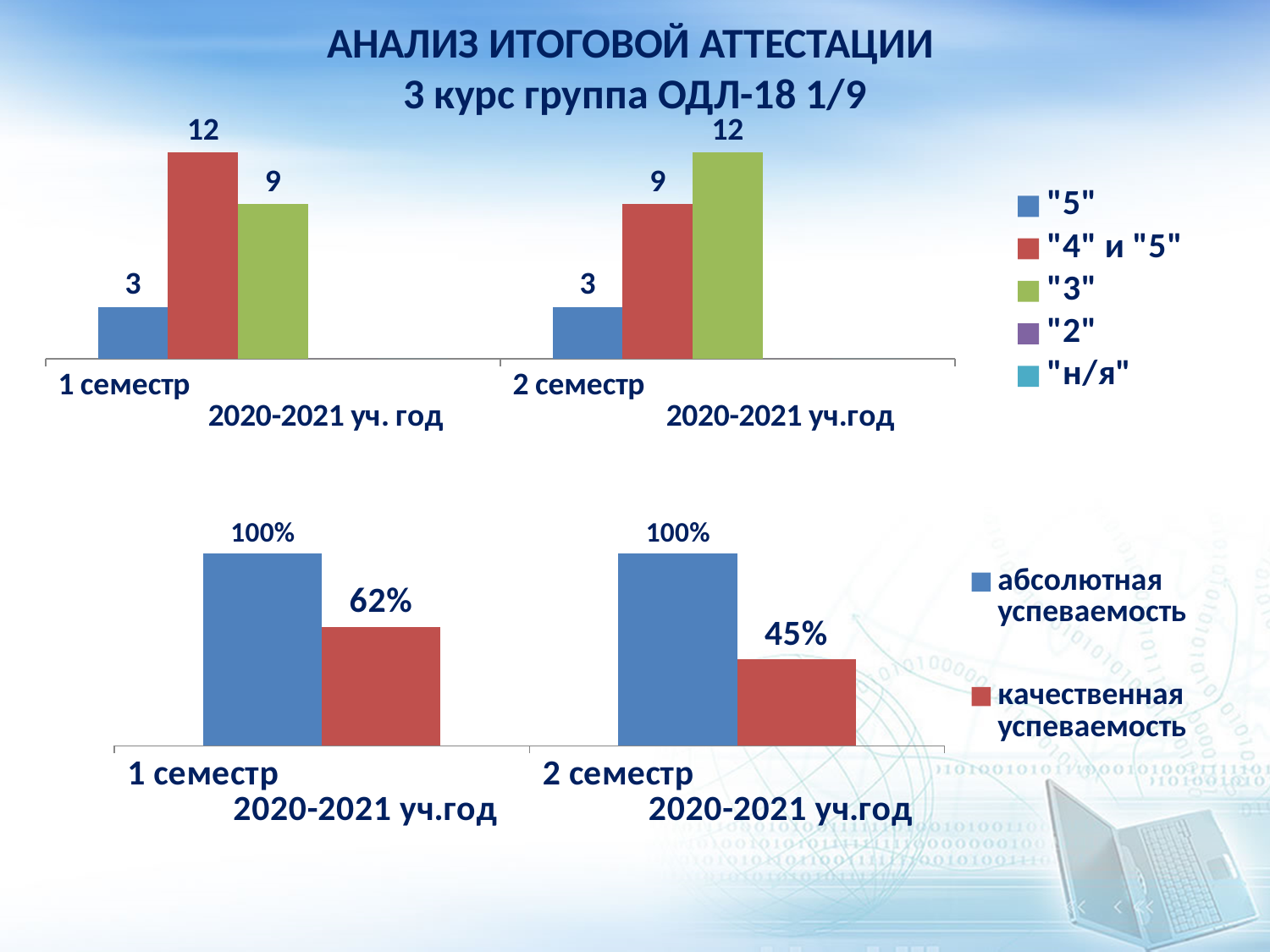
In the bottom chart, what is the value for качественная успеваемость in 2 семестр 2020-2021 уч.год? 45% In the top chart, what is the value for "3" in 2 семестр 2020-2021 уч.год? 12 In the top chart, which series has the highest value in 1 семестр 2020-2021 уч. год? "4" и "5" In the bottom chart, what is the value for абсолютная успеваемость in 1 семестр 2020-2021 уч.год? 100% How many series does the legend of the top chart list? 5 In the top chart, what is the value for "4" и "5" in 1 семестр 2020-2021 уч. год? 12 In the top chart, is the value for "3" larger in 1 семестр or in 2 семестр? 2 семестр In the bottom chart, does качественная успеваемость rise or fall from 1 семестр to 2 семестр? fall In the bottom chart, what is the difference between качественная успеваемость in 1 семестр and in 2 семестр? 17% What kind of chart is the bottom chart? bar chart In the top chart, what is the difference between the "4" и "5" value and the "3" value in 1 семестр 2020-2021 уч. год? 3 In the top chart, what is the value for "5" in 2 семестр 2020-2021 уч.год? 3